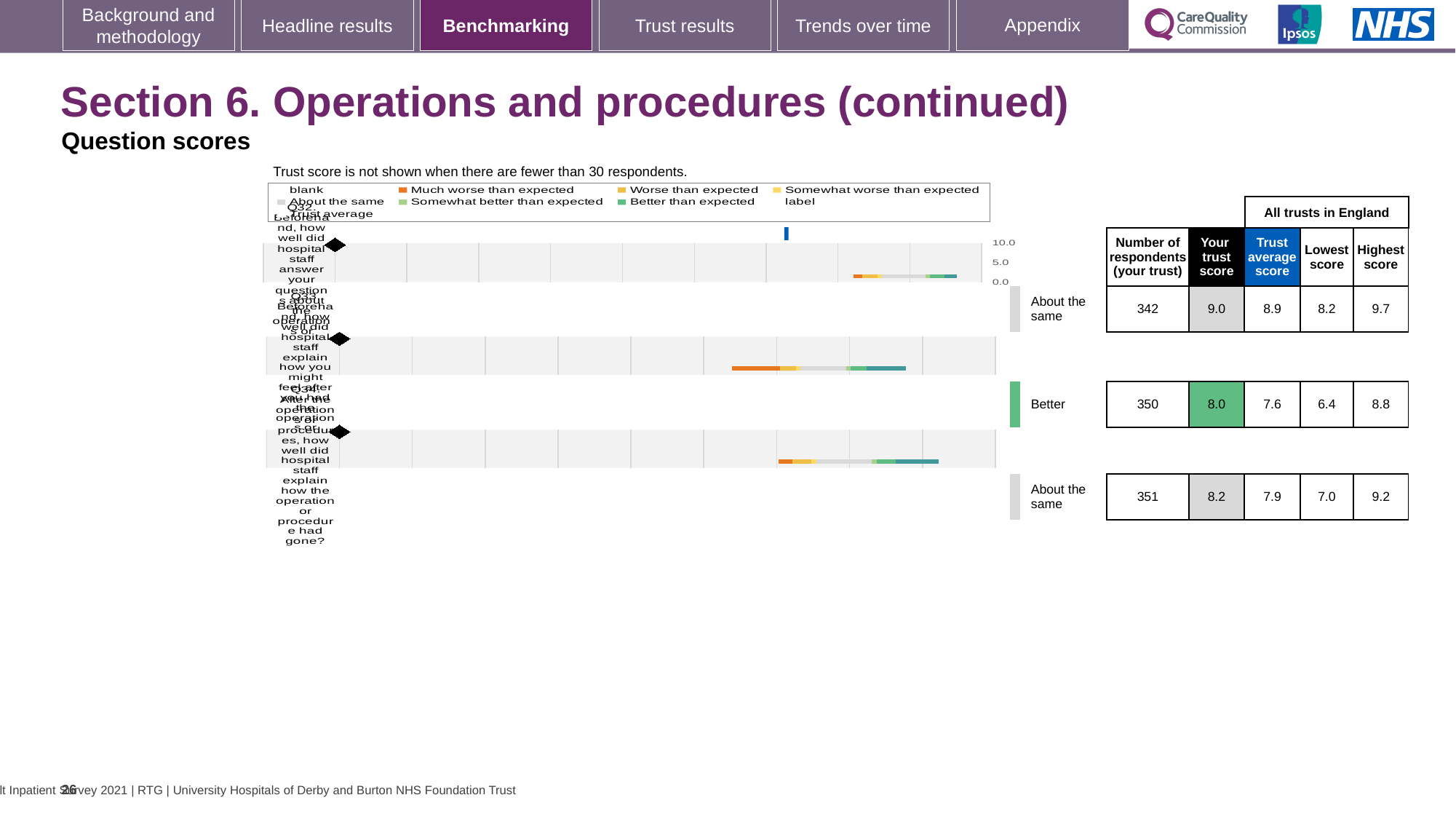
What benchmark category is shown for the second question row? Better What is the 'Your trust score' value for the first (top) question row? 9.0 How many respondents are listed for the second question row? 350 For the third question row, which is larger: the trust score or the trust average score? Trust score (8.2) What is the difference between the highest score and the lowest score for the second question row? 2.4 By how much does the trust score exceed the trust average score for the second question row? 0.4 Which question row has the highest 'Your trust score'? The first (top) row, 9.0 How many question rows are plotted in the benchmarking chart? 3 What is the lowest score across all trusts in England for the third question row? 7.0 Is the trust score for the first question row greater or less than 5.0? greater What kind of chart is shown on the slide? Bar chart What note is printed above the chart about when the trust score is not shown? Trust score is not shown when there are fewer than 30 respondents.